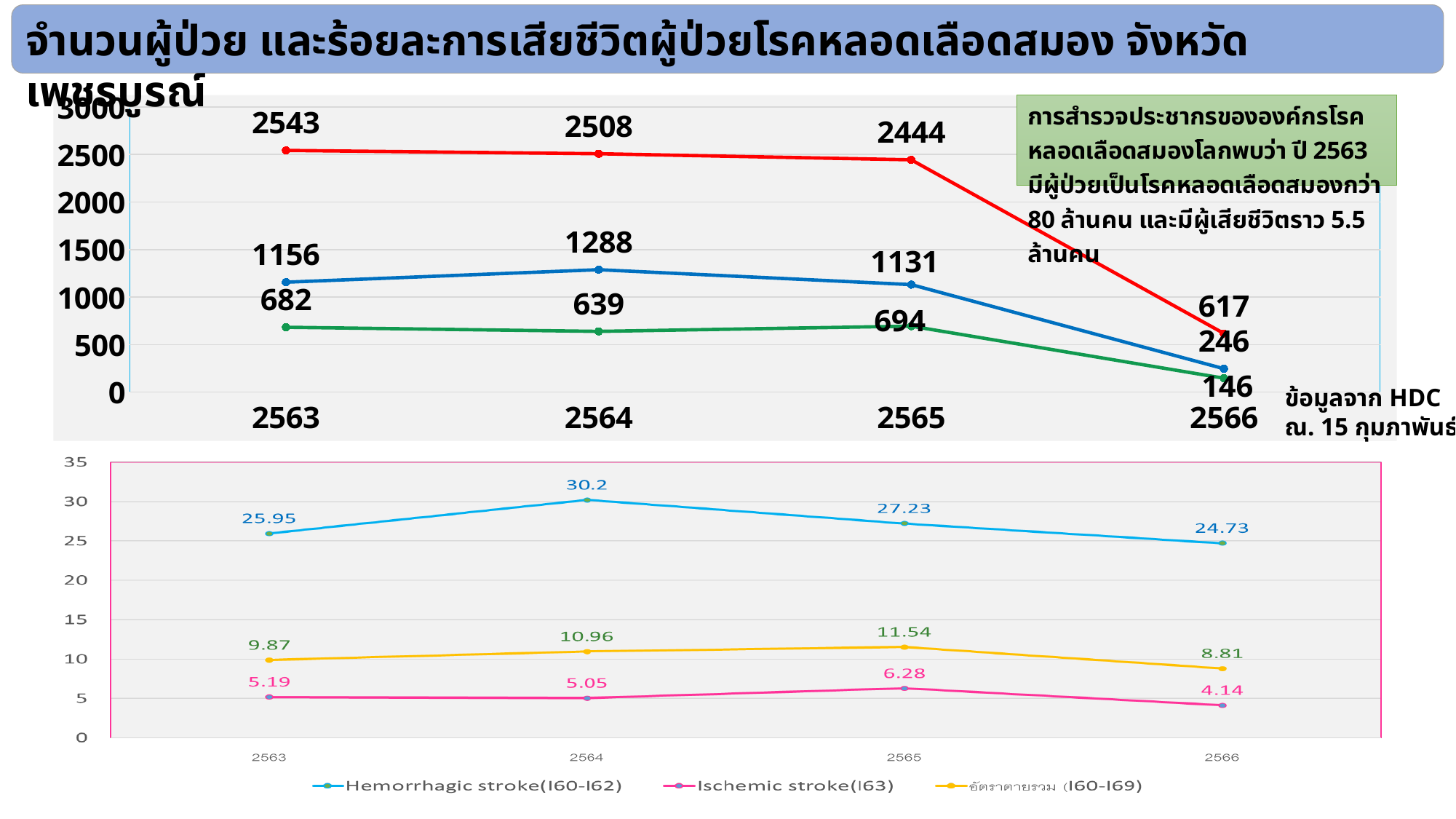
In the bottom chart, what is the value for Ischemic stroke(I63) in 2566? 4.14 How many series does the legend of the bottom chart list? 3 In the top chart, how many years are shown on the x axis? 4 In the bottom chart, what is the value for Hemorrhagic stroke(I60-I62) in 2564? 30.2 In the bottom chart, which is larger: Hemorrhagic stroke(I60-I62) in 2563 or in 2566? 2563 In the top chart, what is the value of the red line for 2563? 2543 What type of chart is the bottom chart? line chart In the bottom chart, in which year is the value for อัตราตายรวม (I60-I69) highest? 2565 In the top chart, what is the difference between the red line values for 2565 and 2566? 1827 In the top chart, does the red line rise or fall from 2563 to 2566? fall In the top chart, in which year does the red line reach its lowest value? 2566 In the top chart, what is the value of the blue line for 2564? 1288